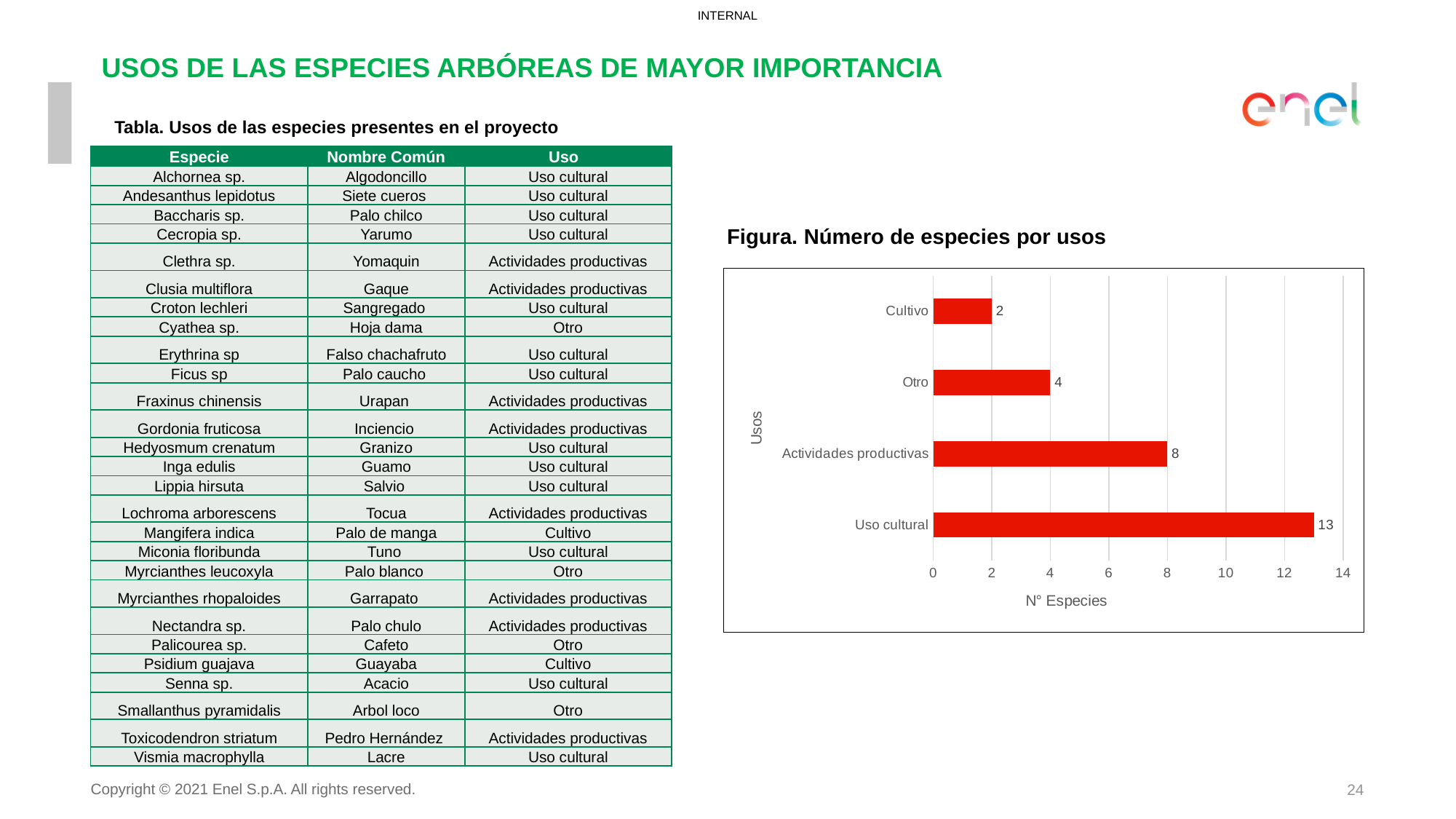
What is the number of species for Cultivo? 2 What is the difference in number of species between Uso cultural and Actividades productivas? 5 How many use categories are shown in the chart? 4 Is the value for Actividades productivas greater or less than 10? less Which use has the highest number of species? Uso cultural What is the number of species for Actividades productivas? 8 What is the title of the figure? Figura. Número de especies por usos Which use has the lowest number of species? Cultivo What is the number of species for Otro? 4 What kind of chart is shown in the figure? bar chart Which has more species, Otro or Cultivo? Otro What is the number of species for Uso cultural? 13